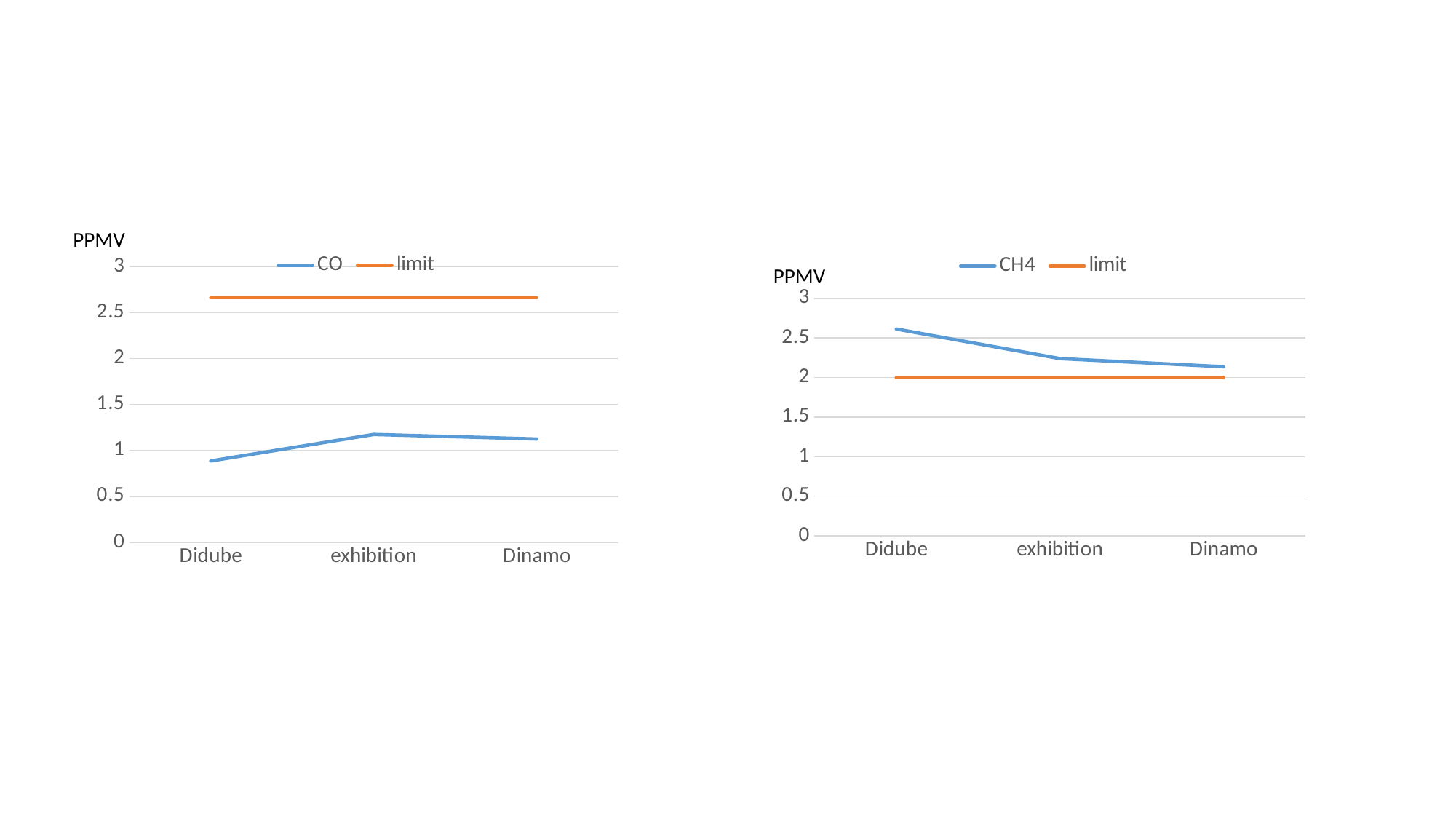
In the left chart, which is larger: the CO value for Didube or for exhibition? exhibition What unit label is shown above the y axis of both charts? PPMV In the left chart, is the CO value for exhibition greater or less than 1? greater In the right chart, does the CH4 line rise or fall from Didube to Dinamo? fall In the right chart showing CH4, which category has the highest CH4 value? Didube In the left chart showing CO, which category has the lowest CO value? Didube In the left chart, is the limit line greater or less than 2.5? greater In the left chart, is the CO value for Didube greater or less than 1? less What kind of chart is the left chart showing CO? line chart How many series does the legend of the left chart showing CO list? 2 How many categories are on the x axis of the right chart showing CH4? 3